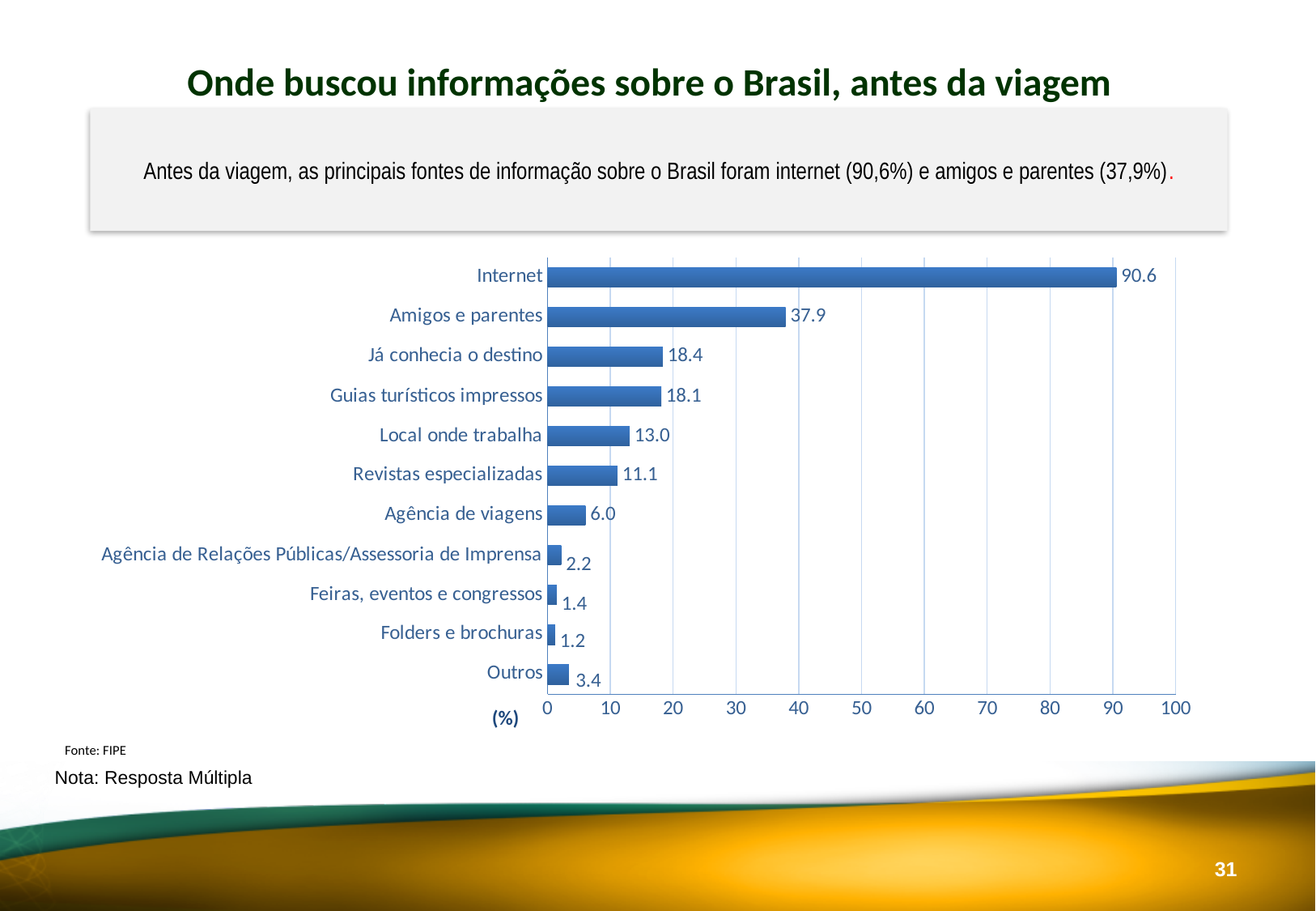
What is the value for Local onde trabalha? 13.0 Which category has the lowest value? Folders e brochuras Is the value for Já conhecia o destino greater or less than 20? less What is the label shown on the horizontal axis of the chart? (%) What is the value for Amigos e parentes? 37.9 What is the difference between the values for Internet and Amigos e parentes? 52.7 What kind of chart is shown on the slide? bar chart Which is larger, the value for Revistas especializadas or the value for Agência de viagens? Revistas especializadas Which category has the highest value? Internet What is the value for Internet? 90.6 What is the value for Agência de viagens? 6.0 How many categories are shown in the chart? 11